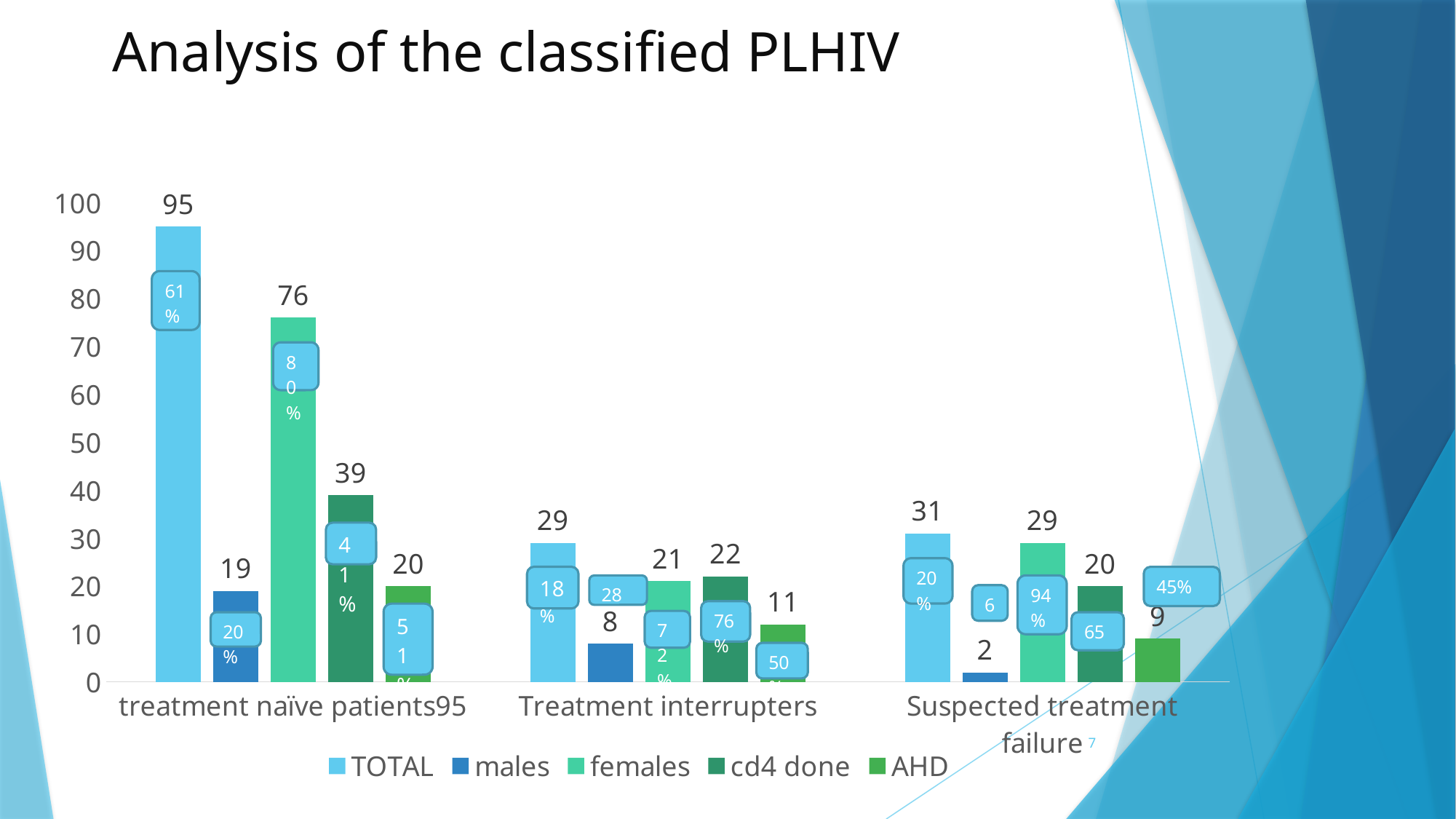
How many series does the legend list? 5 What kind of chart is shown on the slide? bar chart What is the cd4 done value for Treatment interrupters? 22 Which is larger for Suspected treatment failure, the cd4 done value or the AHD value? cd4 done What is the males value for Suspected treatment failure? 2 What is the TOTAL value for Treatment interrupters? 29 How many categories are shown on the x axis? 3 Which category has the lowest males value? Suspected treatment failure Which category has the highest TOTAL value? treatment naïve patients95 What is the difference between the TOTAL and females values for treatment naïve patients95? 19 Which series is shown in the darkest blue colour in the legend? males What is the females value for treatment naïve patients95? 76